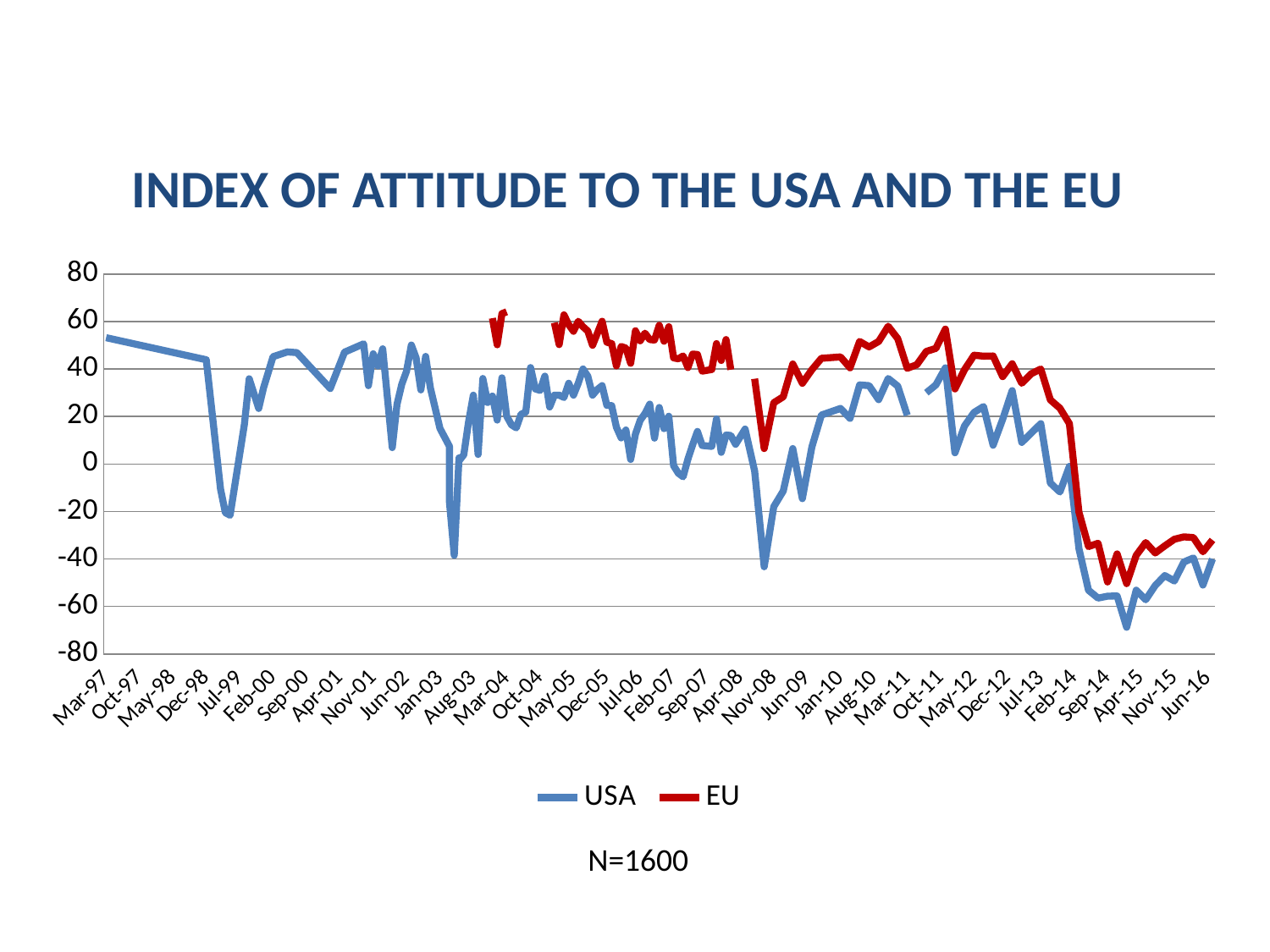
Do the USA and EU values rise or fall between Jul-13 and Sep-14? Fall What kind of chart is shown on the slide? Line chart How many series does the legend list? 2 At Feb-07, which series has the higher value, USA or EU? EU Is the USA value at Sep-14 greater or less than -40? less What is the title of the chart? INDEX OF ATTITUDE TO THE USA AND THE EU What colour is the EU line in the chart? Red Is the USA value at Jul-99 greater or less than 0? less Is the EU value at Jun-16 greater or less than -20? less At Jun-16, which series has the higher value, USA or EU? EU Which series reaches the lowest value anywhere on the chart? USA